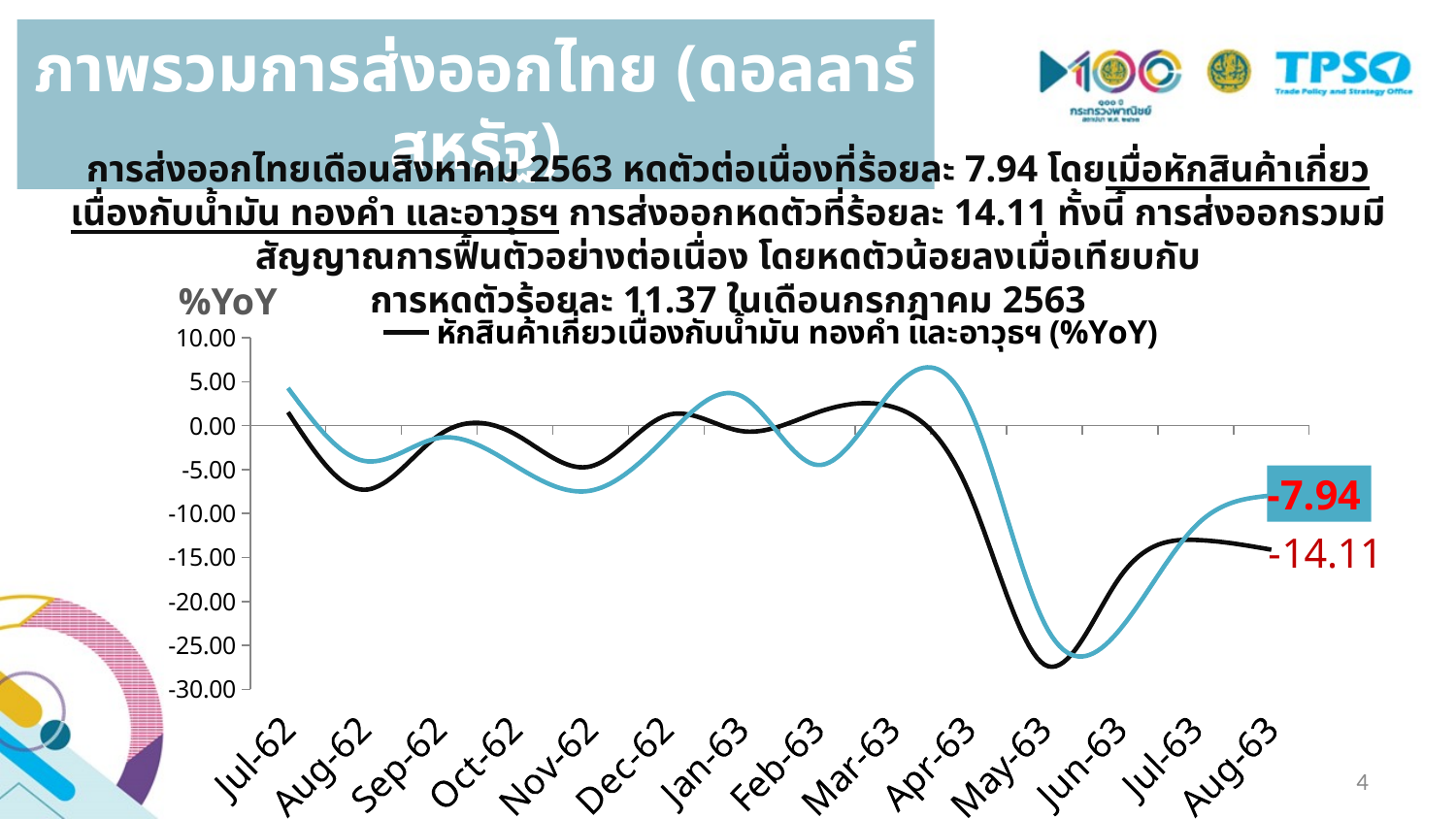
Is the value of the black line for Aug-62 greater or less than -5.00? less What is the value of the blue line for Aug-63? -7.94 Is the value of the black line for May-63 greater or less than -25.00? less How many months are shown along the x axis of the chart? 14 What kind of chart is shown on the slide? line chart Do the lines rise or fall from May-63 to Aug-63? rise For Aug-63, which line has the higher value, the blue line or the black line? the blue line What label is shown on the y axis of the chart? %YoY Is the value of the blue line for Apr-63 greater or less than 0.00? greater What is the difference between the blue line value (-7.94) and the black line value (-14.11) for Aug-63? 6.17 In which month does the black line reach its lowest point? May-63 What is the value of the black line (exports excluding oil, gold and weapons) for Aug-63? -14.11